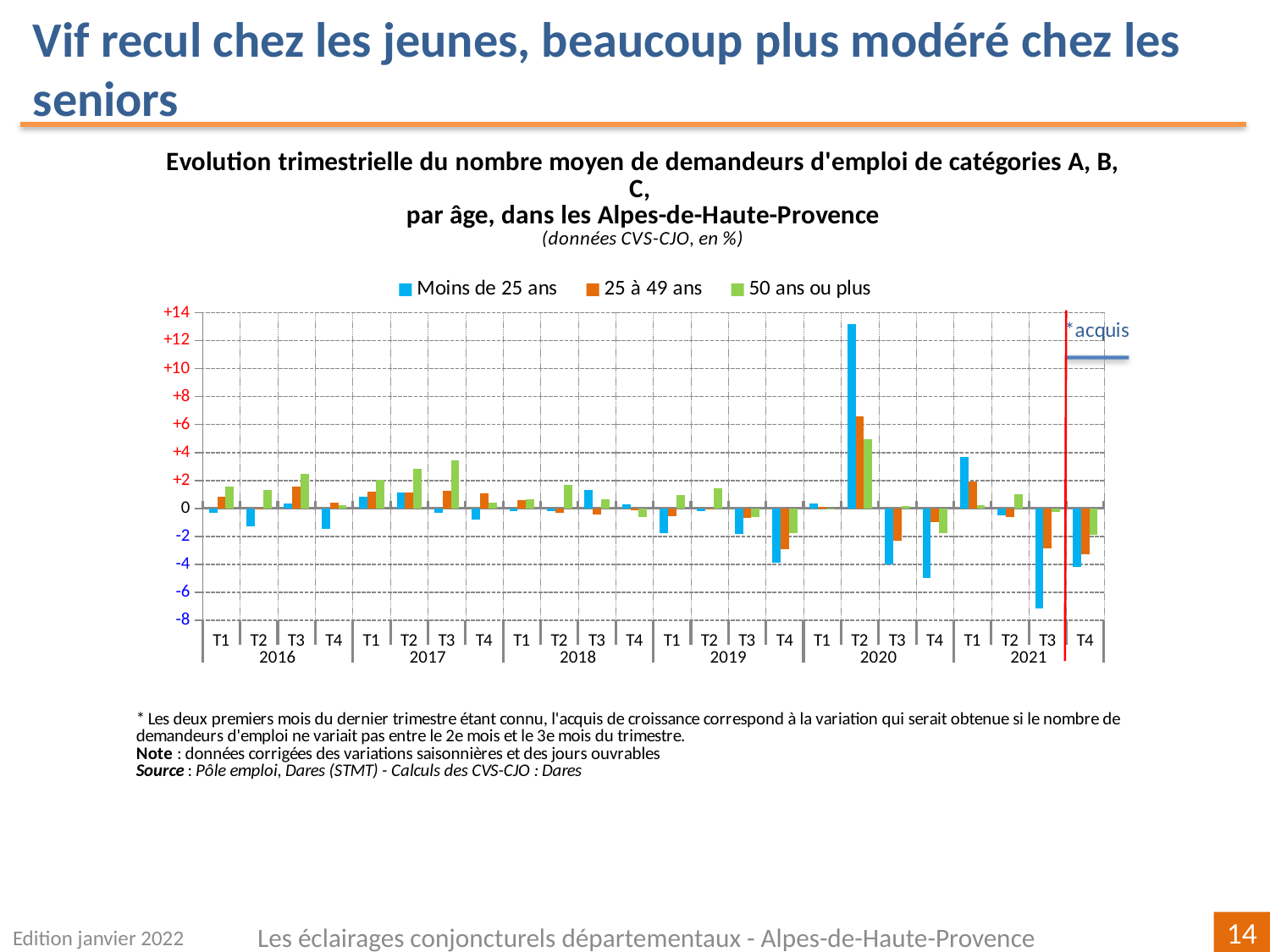
Is the value for '25 à 49 ans' in T2 2020 greater or less than +4? greater In T3 2017, which is larger: the value for '50 ans ou plus' or for 'Moins de 25 ans'? 50 ans ou plus Is the value for 'Moins de 25 ans' in T2 2020 greater or less than +10? greater What kind of chart is shown on the slide? bar chart In T2 2020, which is larger: the value for 'Moins de 25 ans' or for '25 à 49 ans'? Moins de 25 ans Is the value for 'Moins de 25 ans' in T1 2021 greater or less than +2? greater How many years are shown along the x axis? 6 Which series is shown in blue in the legend? Moins de 25 ans How many series does the legend list? 3 In which quarter does the 'Moins de 25 ans' series reach its lowest value? T3 2021 In which quarter does the 'Moins de 25 ans' series reach its highest value? T2 2020